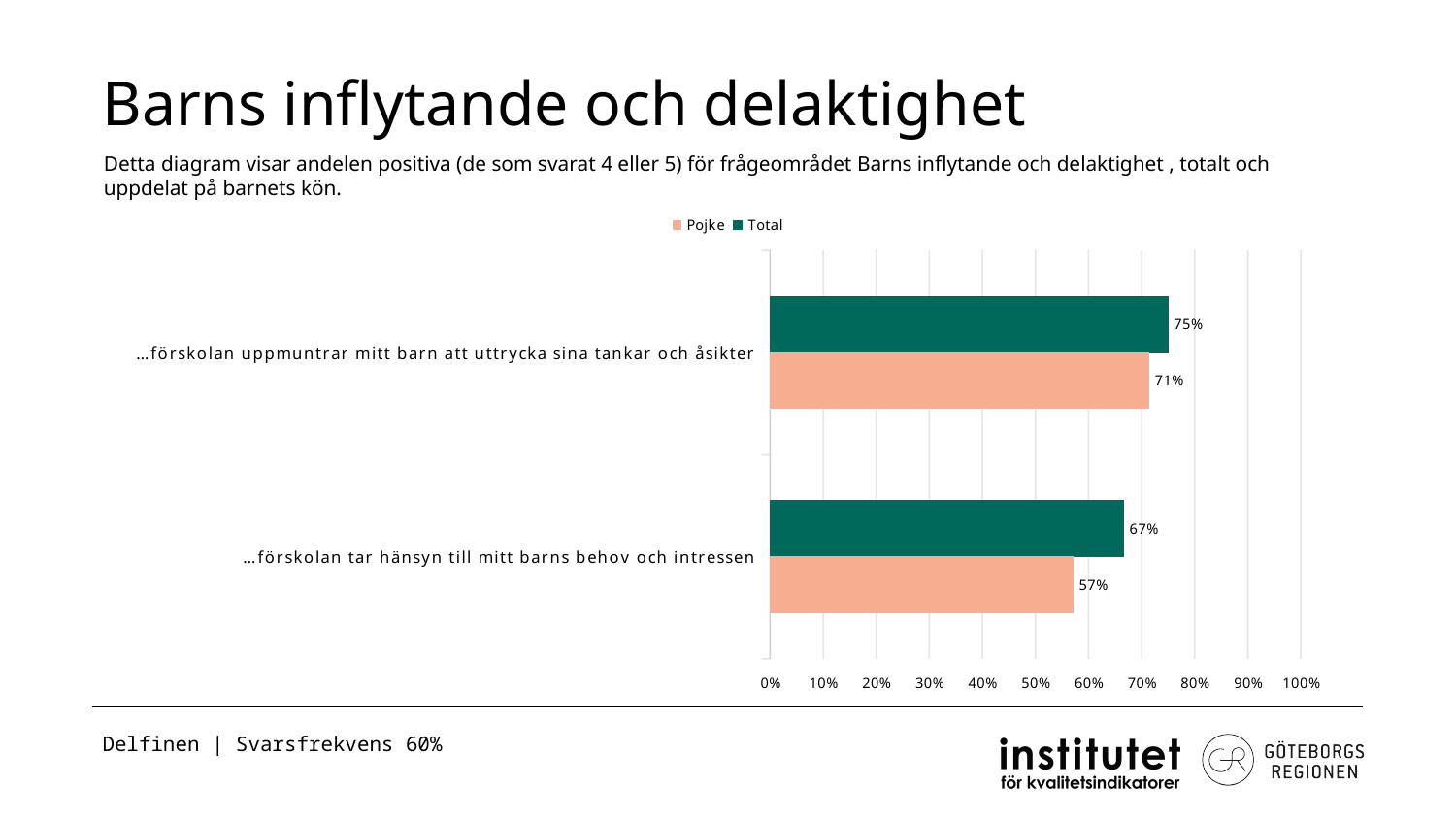
Which category has the highest Total value? …förskolan uppmuntrar mitt barn att uttrycka sina tankar och åsikter What is the Pojke value for "…förskolan uppmuntrar mitt barn att uttrycka sina tankar och åsikter"? 71% What is the Pojke value for "…förskolan tar hänsyn till mitt barns behov och intressen"? 57% How many series does the legend list? 2 How many categories are shown in the chart? 2 Which category has the lowest Pojke value? …förskolan tar hänsyn till mitt barns behov och intressen Which is larger for "…förskolan tar hänsyn till mitt barns behov och intressen": the Pojke value or the Total value? Total What is the Total value for "…förskolan uppmuntrar mitt barn att uttrycka sina tankar och åsikter"? 75% What is the difference between the Total and Pojke values for "…förskolan uppmuntrar mitt barn att uttrycka sina tankar och åsikter"? 4% What kind of chart is shown on the slide? Bar chart What is the Total value for "…förskolan tar hänsyn till mitt barns behov och intressen"? 67% What is the difference between the Total and Pojke values for "…förskolan tar hänsyn till mitt barns behov och intressen"? 10%